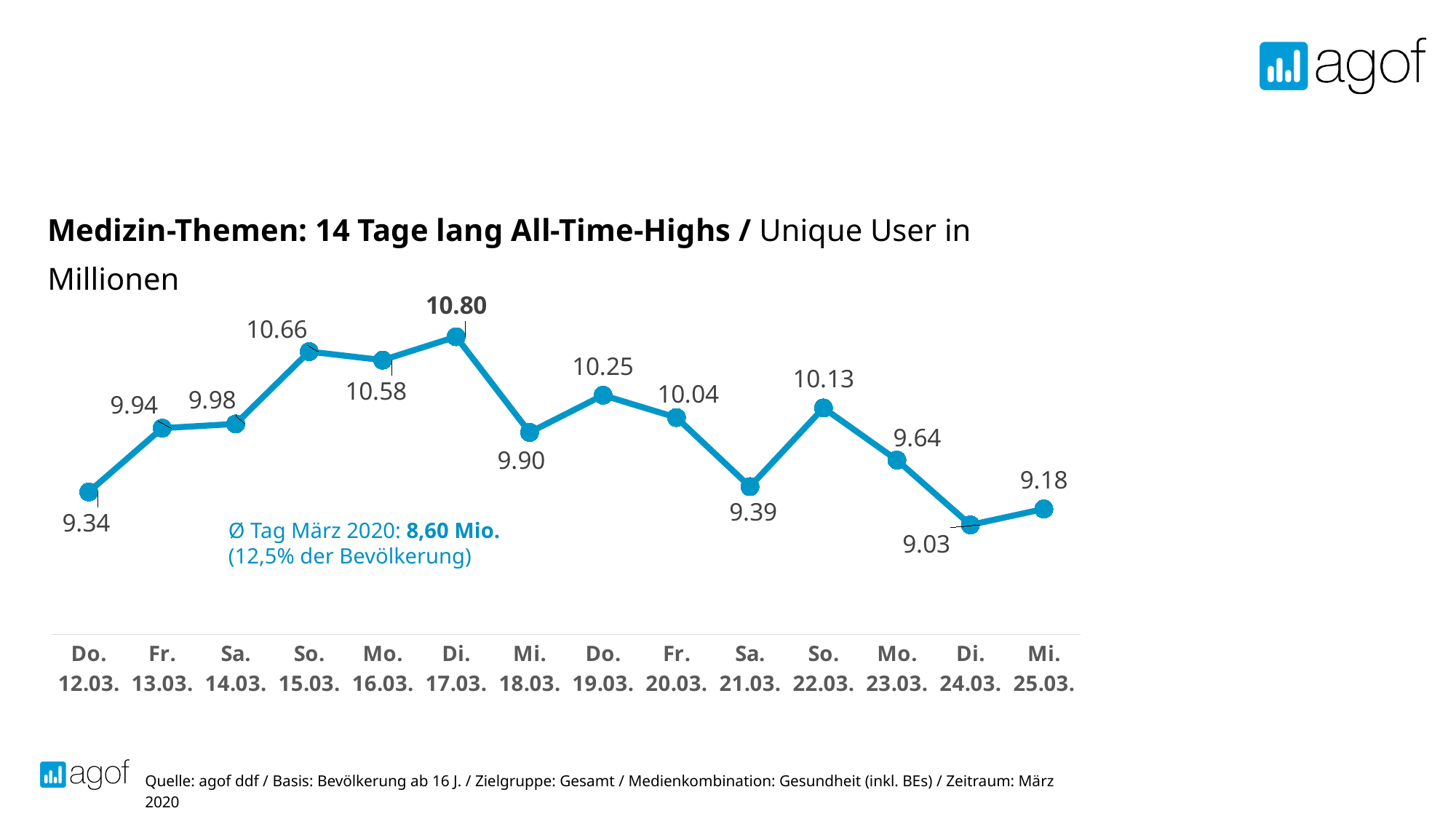
How many data points are plotted on the chart? 14 Do the values rise or fall from Do. 12.03. to So. 15.03.? rise What is the value for Di. 17.03.? 10.80 What is the value for Do. 12.03.? 9.34 What is the difference between the values for Mi. 18.03. and Do. 19.03.? 0.35 What is the value for Sa. 21.03.? 9.39 What is the difference between the values for Di. 17.03. and Di. 24.03.? 1.77 What daily average for March 2020 is stated on the chart? 8,60 Mio. Which date has the lowest value? Di. 24.03. Which is larger, the value for So. 15.03. or the value for So. 22.03.? So. 15.03. Which date has the highest value? Di. 17.03. What kind of chart is shown on the slide? line chart